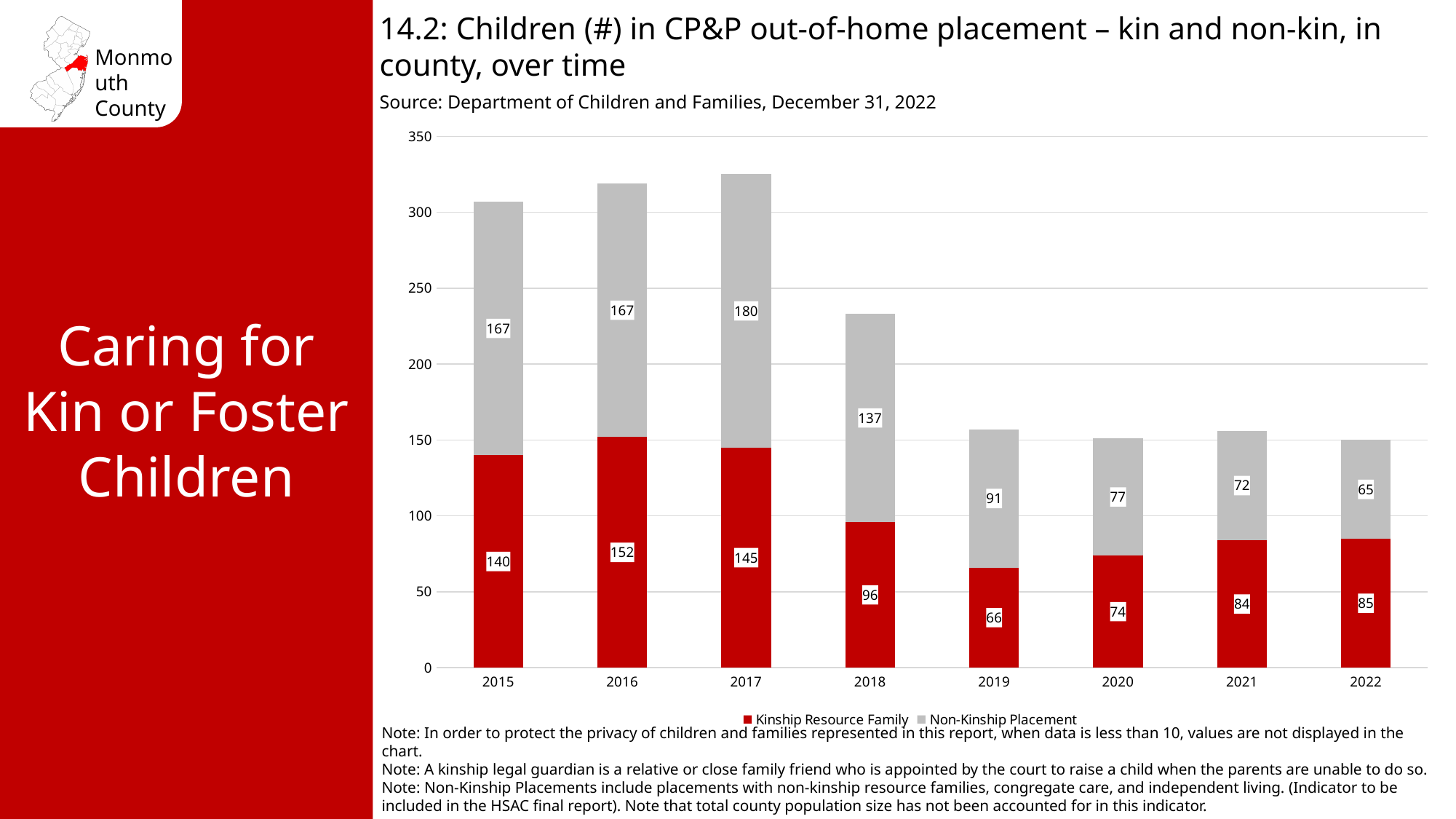
Is the total stacked bar for 2015 greater or less than 300? greater What is the total of the stacked bar for 2020? 151 Which year has the lowest Kinship Resource Family value? 2019 What is the Non-Kinship Placement value for 2017? 180 Which is larger, the Kinship Resource Family value for 2016 or for 2017? 2016 How many series does the legend list? 2 What is the Kinship Resource Family value for 2018? 96 How many years are shown on the x axis? 8 What is the difference between the Non-Kinship Placement values for 2018 and 2019? 46 What is the Kinship Resource Family value for 2022? 85 Which year has the highest Non-Kinship Placement value? 2017 What kind of chart is shown? Stacked bar chart